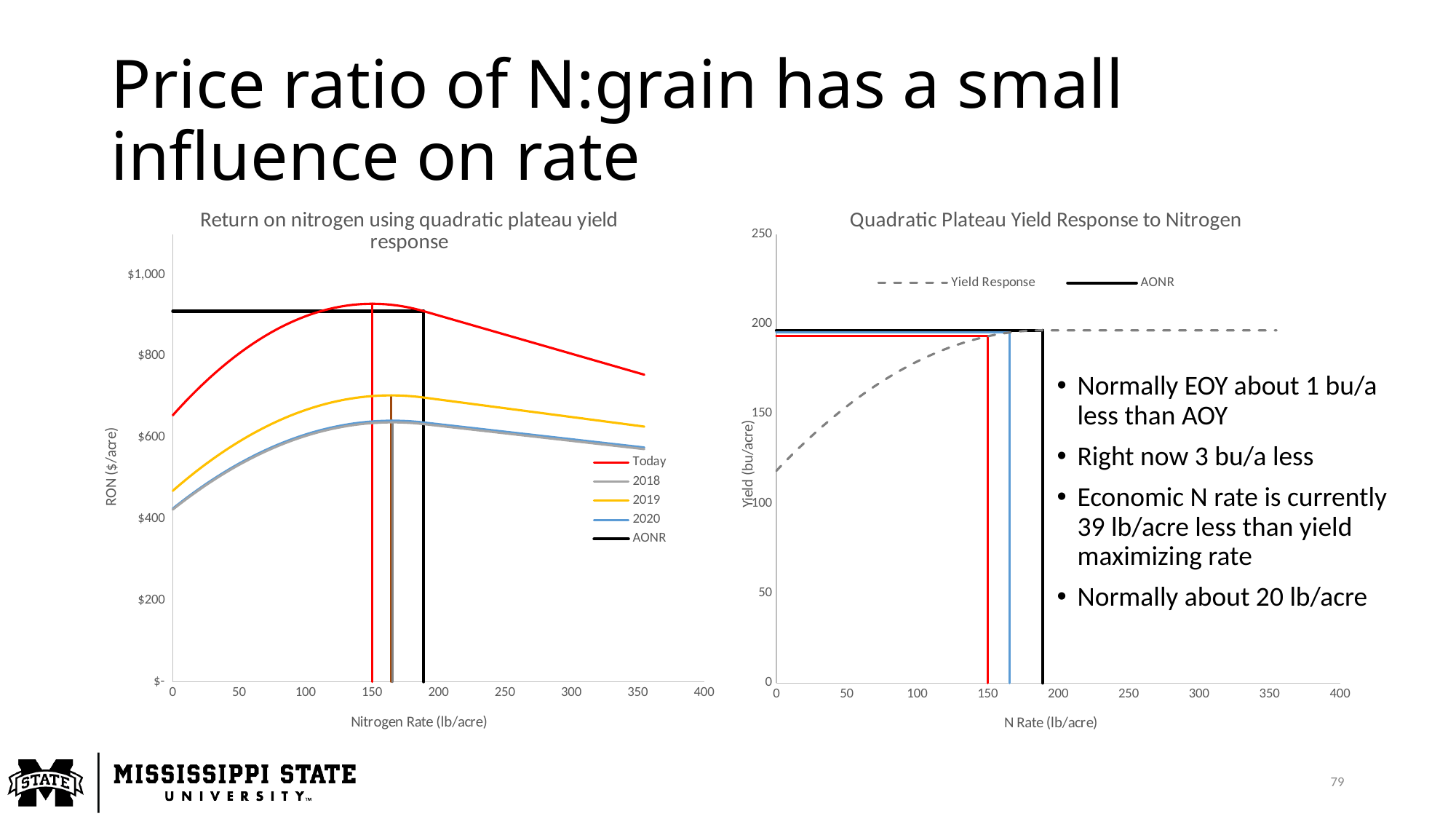
In the left chart (Return on nitrogen), is the value of the 2020 series at a nitrogen rate of 0 greater or less than $600? less What kind of chart is the left chart titled "Return on nitrogen using quadratic plateau yield response"? Line chart What is the x-axis title of the right chart (Quadratic Plateau Yield Response to Nitrogen)? N Rate (lb/acre) In the left chart (Return on nitrogen), which series has the highest return on nitrogen across the nitrogen rates? Today In the right chart (Quadratic Plateau Yield Response to Nitrogen), is the Yield Response value at an N rate of 350 greater or less than 150? greater How many series does the legend of the left chart (Return on nitrogen) list? 5 In the left chart (Return on nitrogen), is the peak value of the 2019 series greater or less than $800? less In the left chart (Return on nitrogen), which is larger at a nitrogen rate of 150 lb/acre: the Today series or the 2019 series? Today In the right chart (Quadratic Plateau Yield Response to Nitrogen), how does the Yield Response line change as N rate increases from 0 to 400? It rises and then plateaus How many series does the legend of the right chart (Quadratic Plateau Yield Response to Nitrogen) list? 2